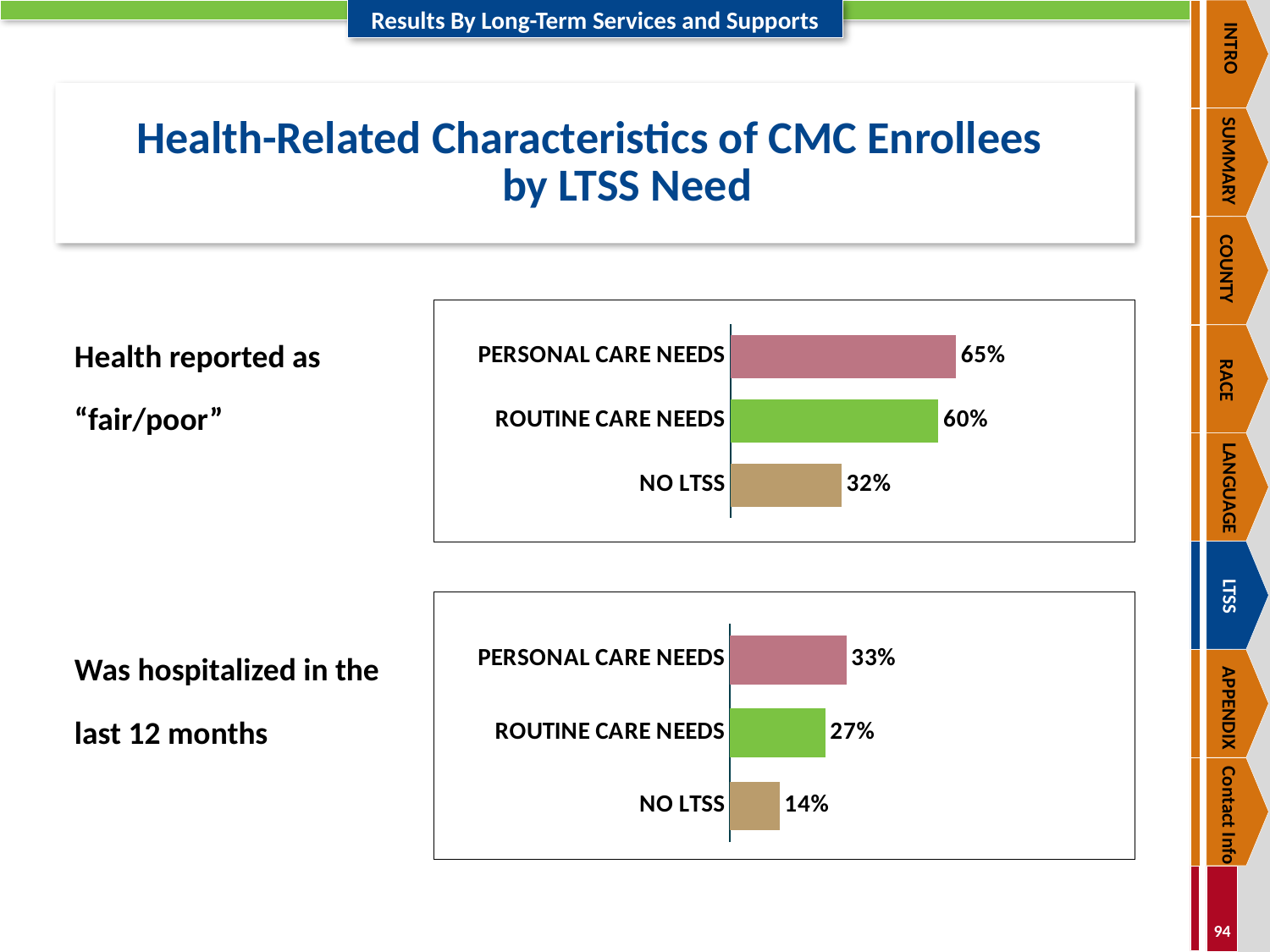
What colour is the NO LTSS bar in the 'Health reported as "fair/poor"' chart? Tan What type of chart is the 'Was hospitalized in the last 12 months' chart? Bar chart How many categories are shown in the 'Health reported as "fair/poor"' chart? 3 In the 'Was hospitalized in the last 12 months' chart, which is larger: PERSONAL CARE NEEDS or NO LTSS? PERSONAL CARE NEEDS In the 'Was hospitalized in the last 12 months' chart, what is the difference between PERSONAL CARE NEEDS and ROUTINE CARE NEEDS? 6% In the 'Was hospitalized in the last 12 months' chart, what is the value for NO LTSS? 14% In the 'Was hospitalized in the last 12 months' chart, which category has the lowest value? NO LTSS In the 'Was hospitalized in the last 12 months' chart, what is the value for ROUTINE CARE NEEDS? 27% In the 'Health reported as "fair/poor"' chart, what is the value for PERSONAL CARE NEEDS? 65% In the 'Health reported as "fair/poor"' chart, which category has the highest value? PERSONAL CARE NEEDS In the 'Health reported as "fair/poor"' chart, what is the difference between PERSONAL CARE NEEDS and NO LTSS? 33% In the 'Health reported as "fair/poor"' chart, what is the value for NO LTSS? 32%